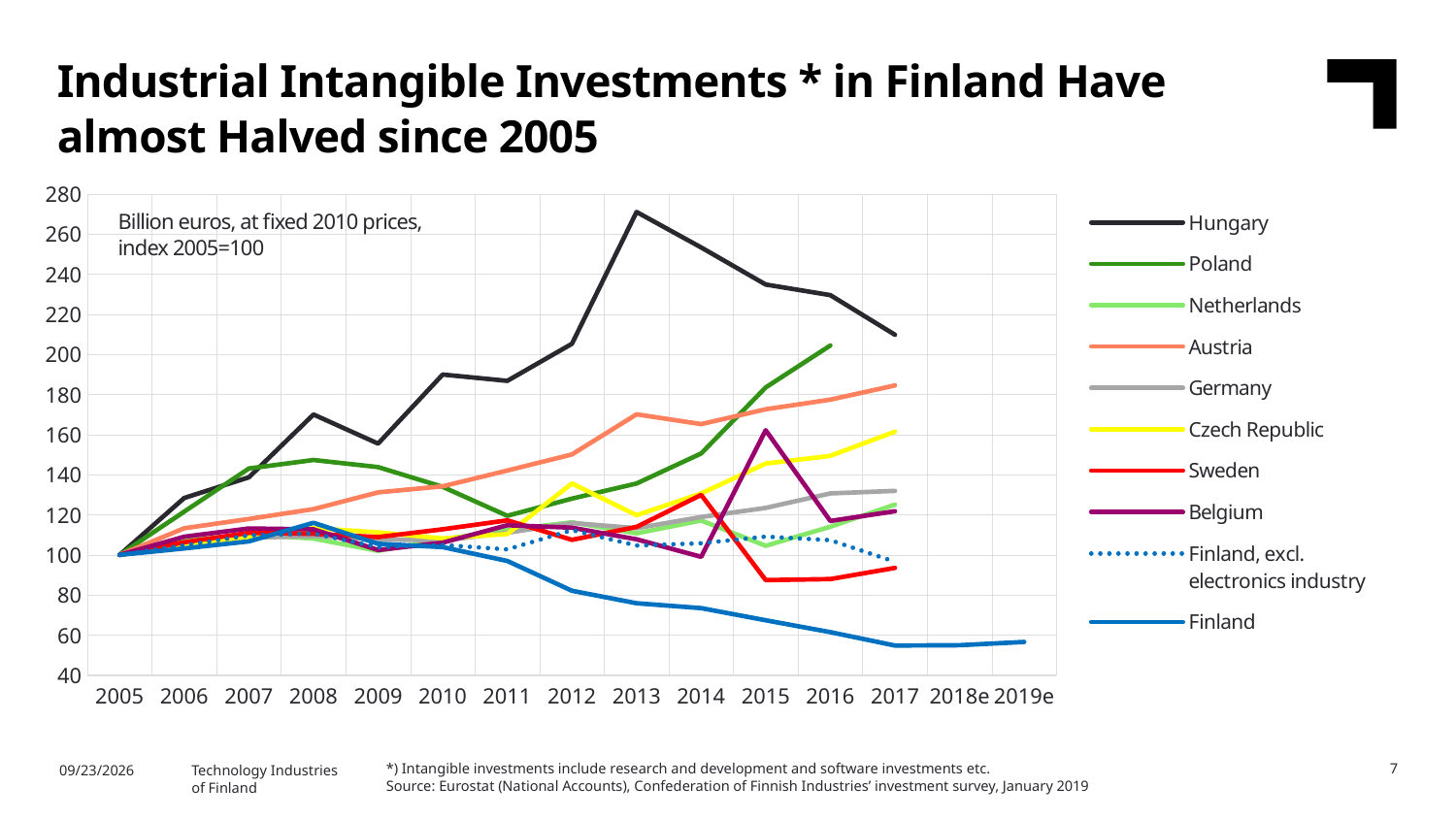
How many series does the legend list? 10 Which series has the lowest value in 2017? Finland What kind of chart is shown on the slide? line chart How many years are shown on the x axis? 15 Is the value for Belgium in 2015 greater or less than 140? greater Which country has the highest index value in 2013? Hungary What is the index value for all countries in 2005? 100 Does the Finland line rise or fall from 2005 to 2017? fall Is the value for Finland in 2017 greater or less than 60? less Is the value for Sweden in 2015 greater or less than 100? less Which is larger in 2017, the value for Hungary or the value for Finland? Hungary